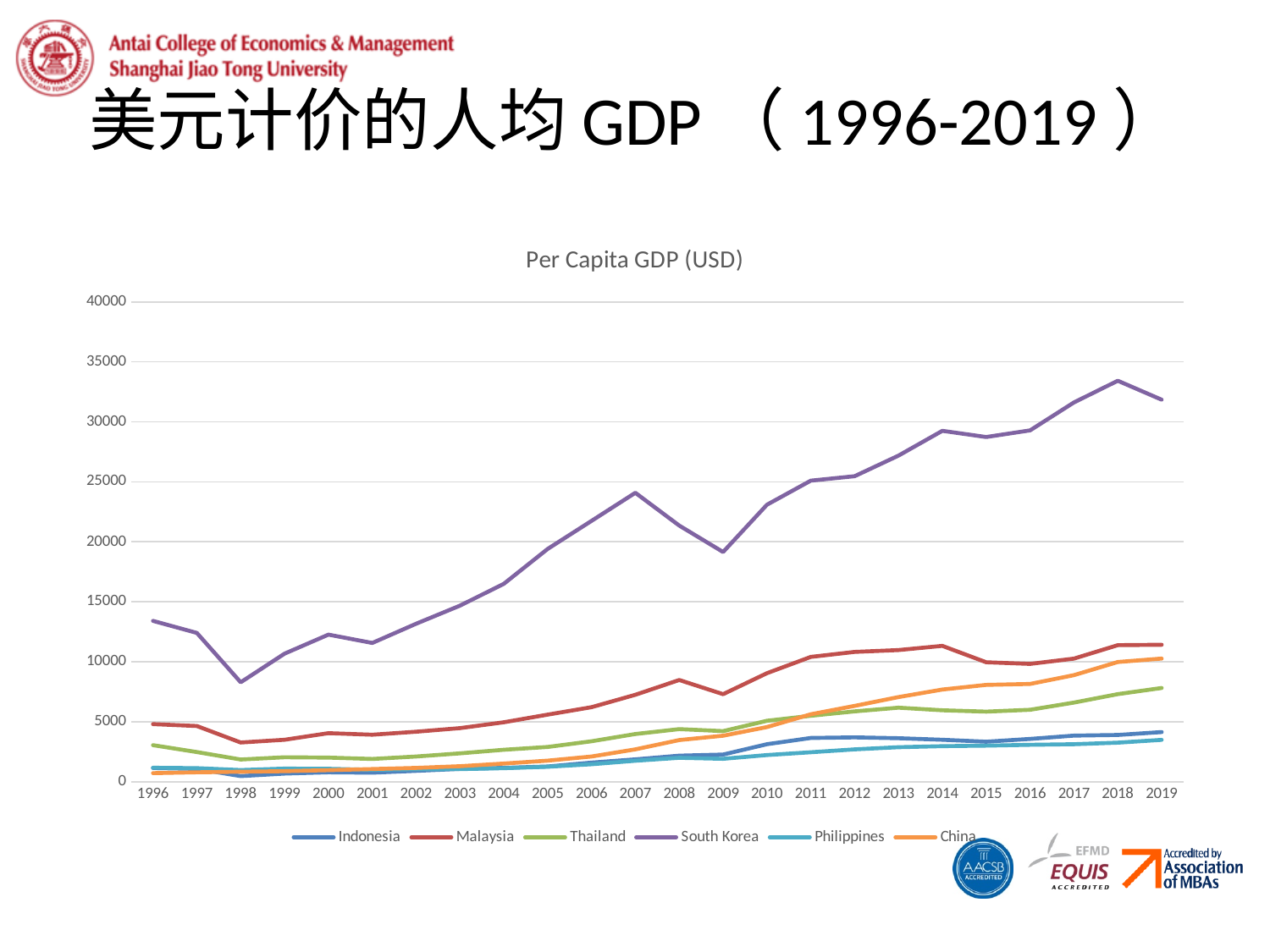
How many years are shown on the x axis? 24 Which country has the lowest per capita GDP in 1996? China Is the value for China in 2019 greater or less than 5000? greater Is the value for South Korea in 2018 greater or less than 30000? greater What kind of chart is shown on the slide? line chart What is the title of the chart? Per Capita GDP (USD) Does the South Korea line rise or fall from 2009 to 2018? rise How many series does the legend list? 6 Is the value for Malaysia in 2014 greater or less than 10000? greater Which country has the highest per capita GDP in 2019? South Korea In 2019, which is larger: the value for China or the value for Thailand? China